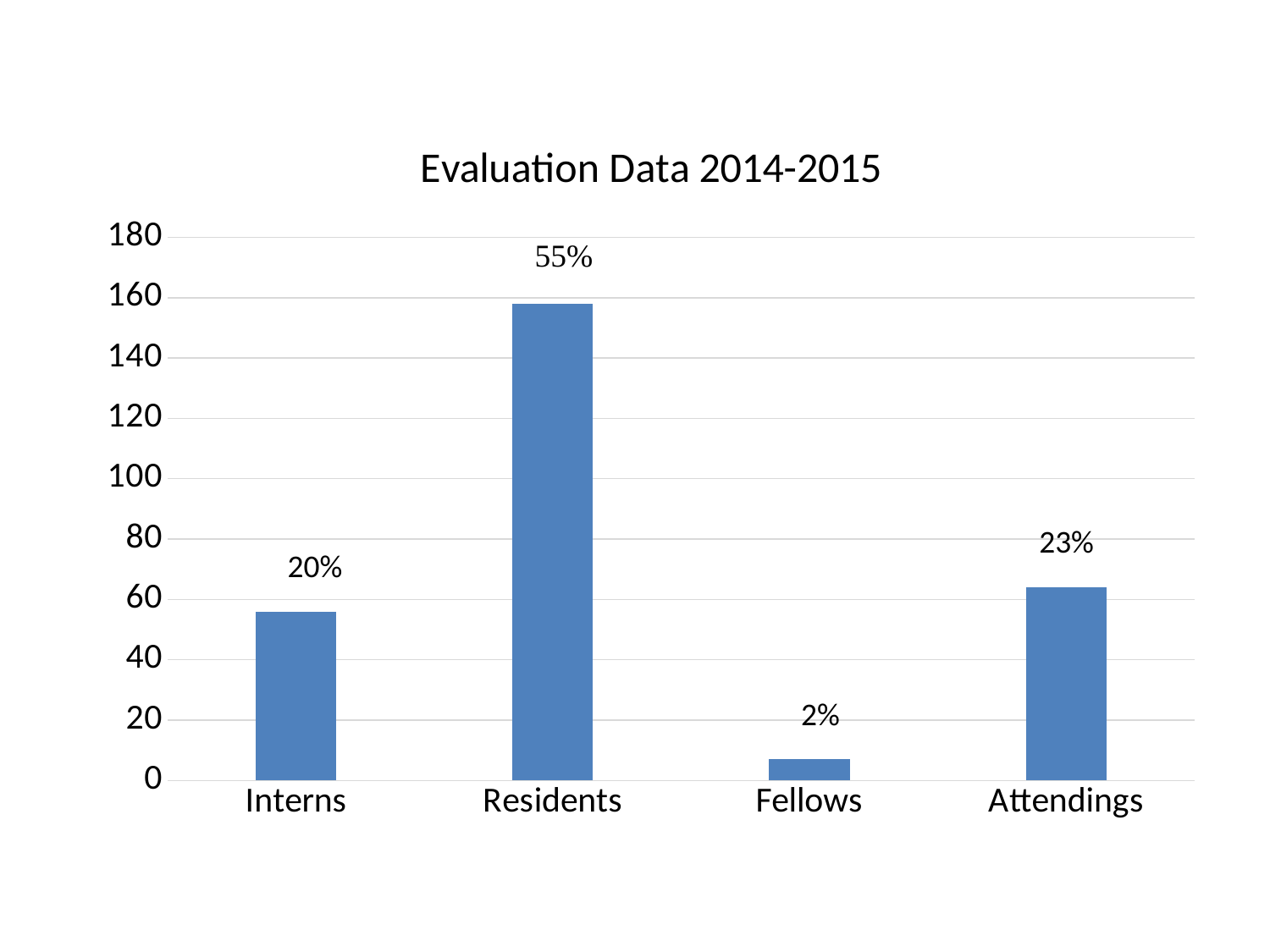
Which category has the lowest bar? Fellows What percentage label is shown above the Attendings bar? 23% What type of chart is shown on the slide? bar chart What is the title of the chart? Evaluation Data 2014-2015 Which bar is taller, Interns or Attendings? Attendings How many categories are shown on the x axis of the chart? 4 What percentage label is shown above the Interns bar? 20% What percentage label is shown above the Fellows bar? 2% Is the value for Interns greater or less than 60? less Is the value for Residents greater or less than 140? greater Which category has the highest bar? Residents What percentage label is shown above the Residents bar? 55%